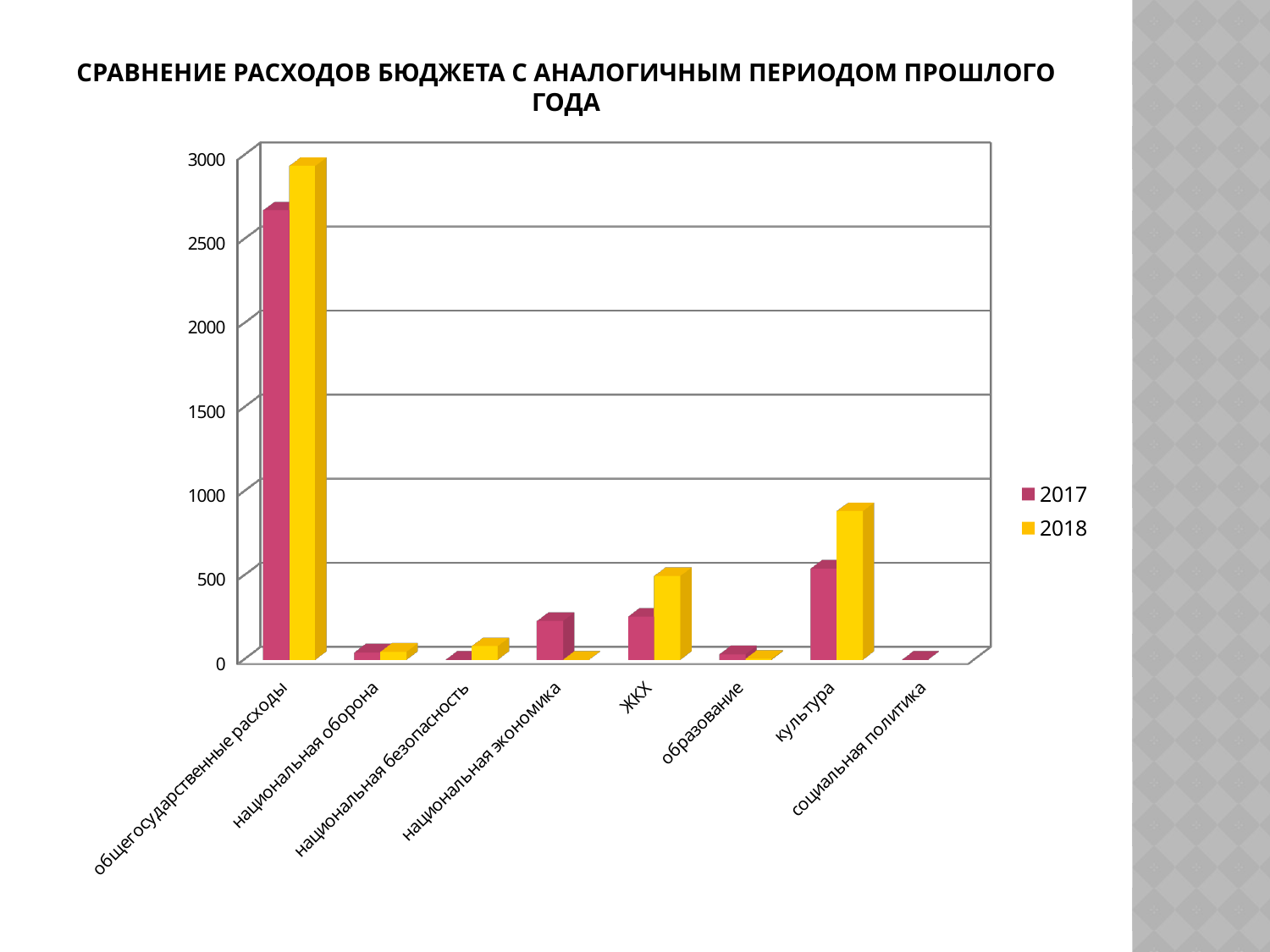
Is the 2017 value for культура greater or less than 1000? less For культура, which series has the larger value, 2017 or 2018? 2018 Is the 2018 value for культура greater or less than 500? greater For национальная экономика, which series has the larger value, 2017 or 2018? 2017 What kind of chart is shown on the slide? bar chart Which category has the highest value for the 2017 series? общегосударственные расходы How many categories are shown on the x axis of the chart? 8 How many series does the legend list? 2 Which series is shown in yellow in the legend? 2018 Which category has the highest value for the 2018 series? общегосударственные расходы Is the 2018 value for общегосударственные расходы greater or less than 2500? greater